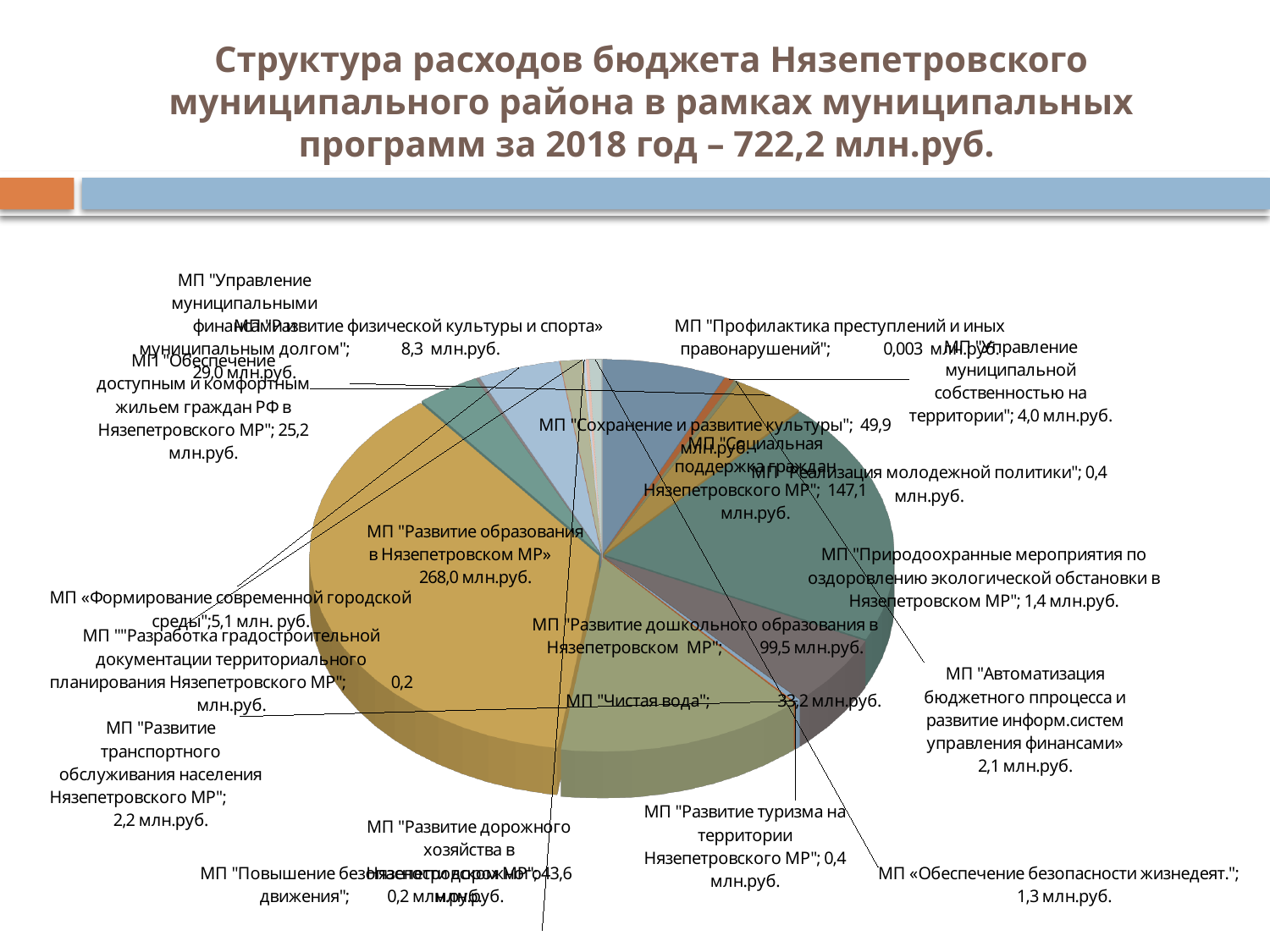
Which program has the smallest value shown on the chart? МП "Профилактика преступлений и иных правонарушений" Which is larger: the value for МП "Сохранение и развитие культуры" or МП "Чистая вода"? МП "Сохранение и развитие культуры" What is the difference between the values for МП "Развитие образования в Нязепетровском МР" and МП "Социальная поддержка граждан Нязепетровского МР"? 120,9 млн.руб. What total amount of budget expenditure is stated in the chart title for 2018? 722,2 млн.руб. What is the value for МП "Развитие образования в Нязепетровском МР"? 268,0 млн.руб. What is the value for МП "Автоматизация бюджетного ппроцесса и развитие информ.систем управления финансами"? 2,1 млн.руб. Which program has the largest share of the pie? МП "Развитие образования в Нязепетровском МР" What is the value for МП "Чистая вода"? 33,2 млн.руб. What is the value for МП "Социальная поддержка граждан Нязепетровского МР"? 147,1 млн.руб. What type of chart is shown on the slide? pie chart What is the value for МП "Развитие дошкольного образования в Нязепетровском МР"? 99,5 млн.руб. What is the value for МП "Сохранение и развитие культуры"? 49,9 млн.руб.